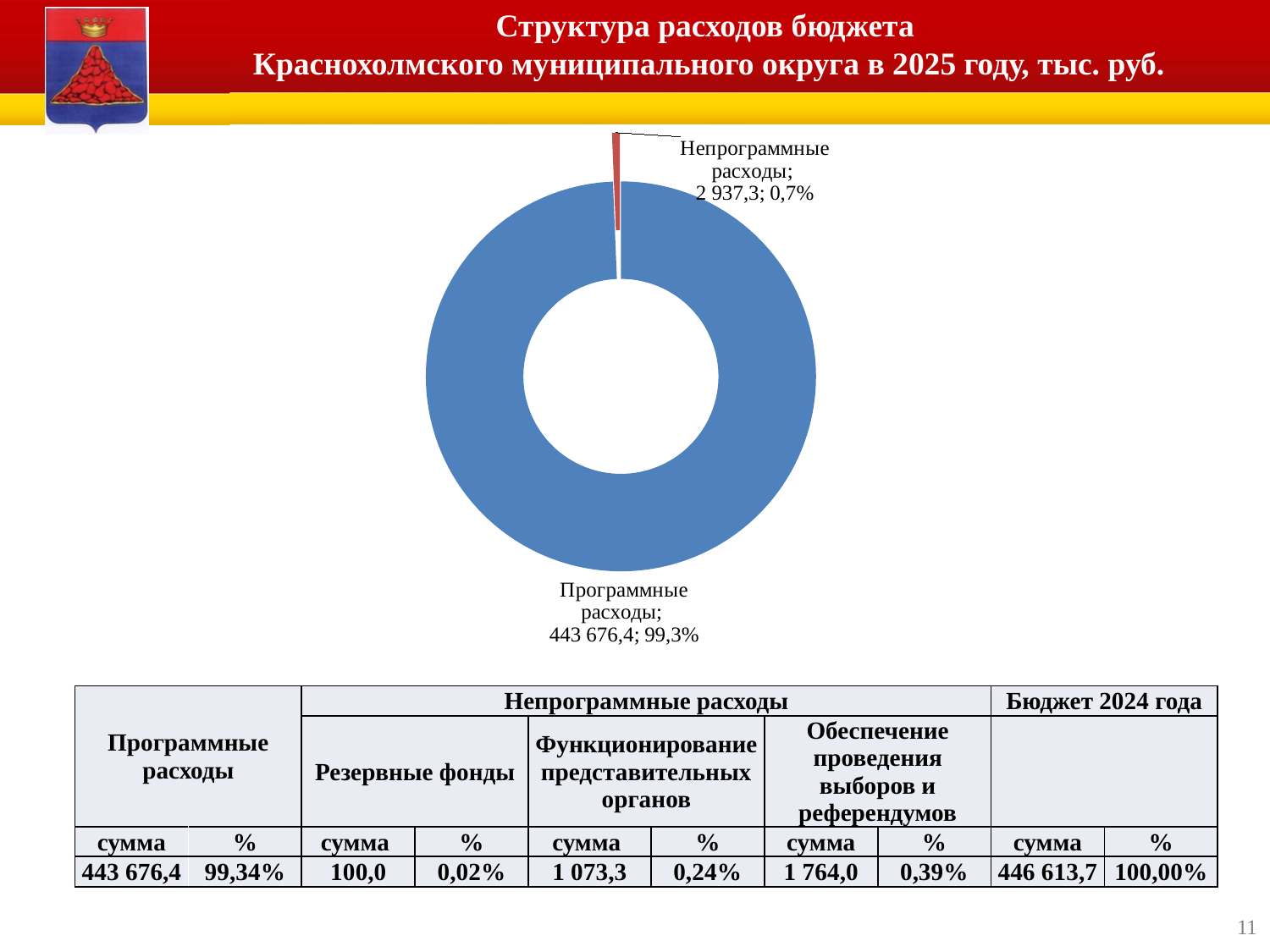
How many categories does the doughnut chart show? 2 What is the value for Непрограммные расходы in the doughnut chart? 2 937,3 What share of the doughnut chart does Программные расходы take? 99,3% What kind of chart is shown on the slide? Doughnut (pie) chart What is the difference between the values for Программные расходы and Непрограммные расходы in the doughnut chart? 440 739,1 What share of the doughnut chart does Непрограммные расходы take? 0,7% What colour is the Непрограммные расходы slice in the doughnut chart? Red Which category is the largest in the doughnut chart? Программные расходы What is the value for Программные расходы in the doughnut chart? 443 676,4 What is the title of the slide containing the doughnut chart? Структура расходов бюджета Краснохолмского муниципального округа в 2025 году, тыс. руб. Which is larger in the doughnut chart: Программные расходы or Непрограммные расходы? Программные расходы Which category is the smallest in the doughnut chart? Непрограммные расходы